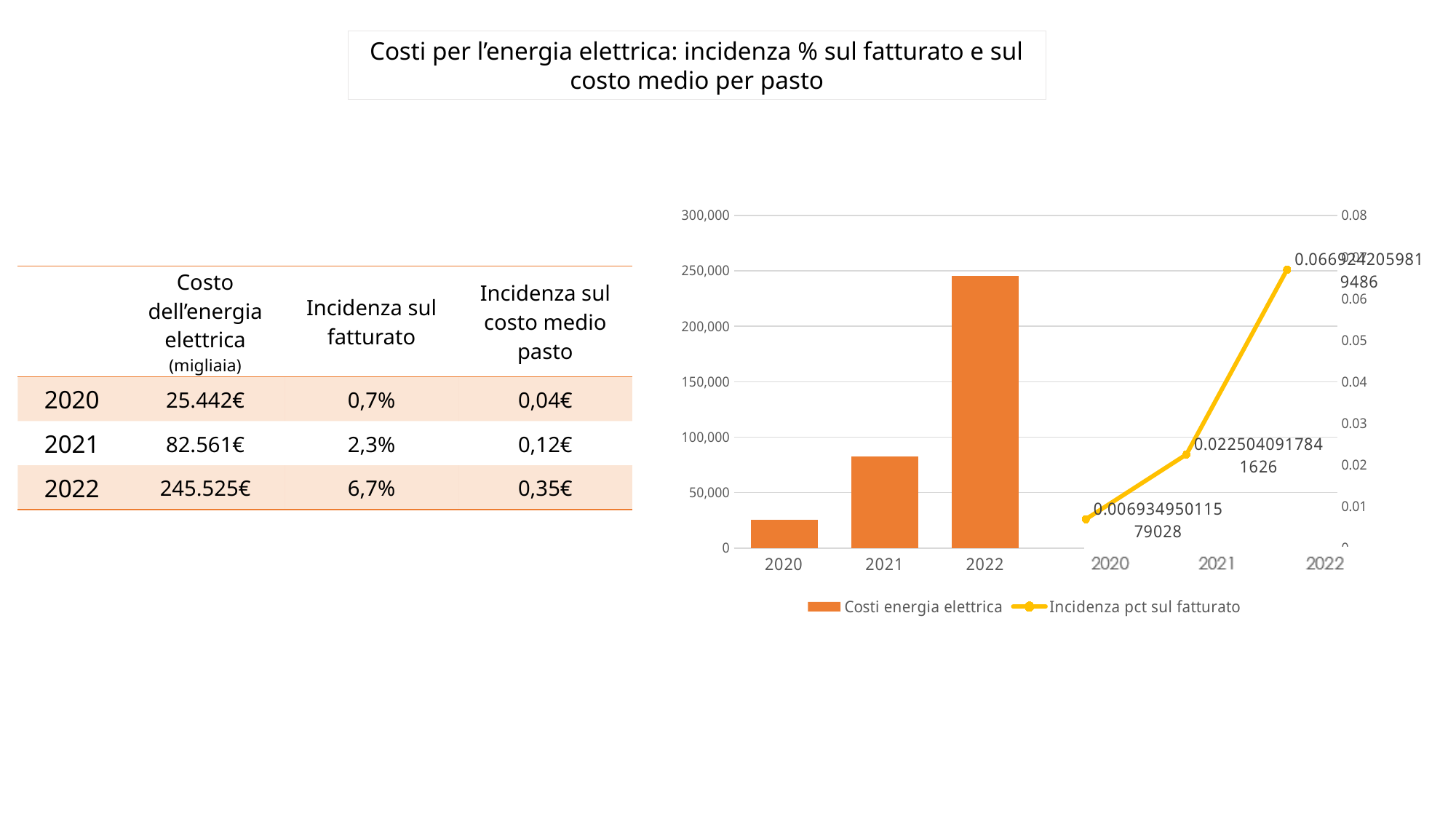
Is the Costi energia elettrica bar for 2021 greater or less than 100,000? less How many years are plotted on the x axis of the chart? 3 What kind of chart is shown on the slide? A combined bar and line chart Is the Costi energia elettrica bar for 2022 greater or less than 200,000? greater Which year has the shortest bar for Costi energia elettrica? 2020 Which year has the tallest bar for Costi energia elettrica? 2022 Which bar is taller, 2021 or 2020? 2021 Does the Incidenza pct sul fatturato line rise or fall from 2020 to 2022? It rises How many series does the chart legend list? 2 Is the Costi energia elettrica bar for 2020 greater or less than 50,000? less What are the two entries in the chart legend? Costi energia elettrica and Incidenza pct sul fatturato What is the data label value of Incidenza pct sul fatturato for 2021? 0.0225040917841626